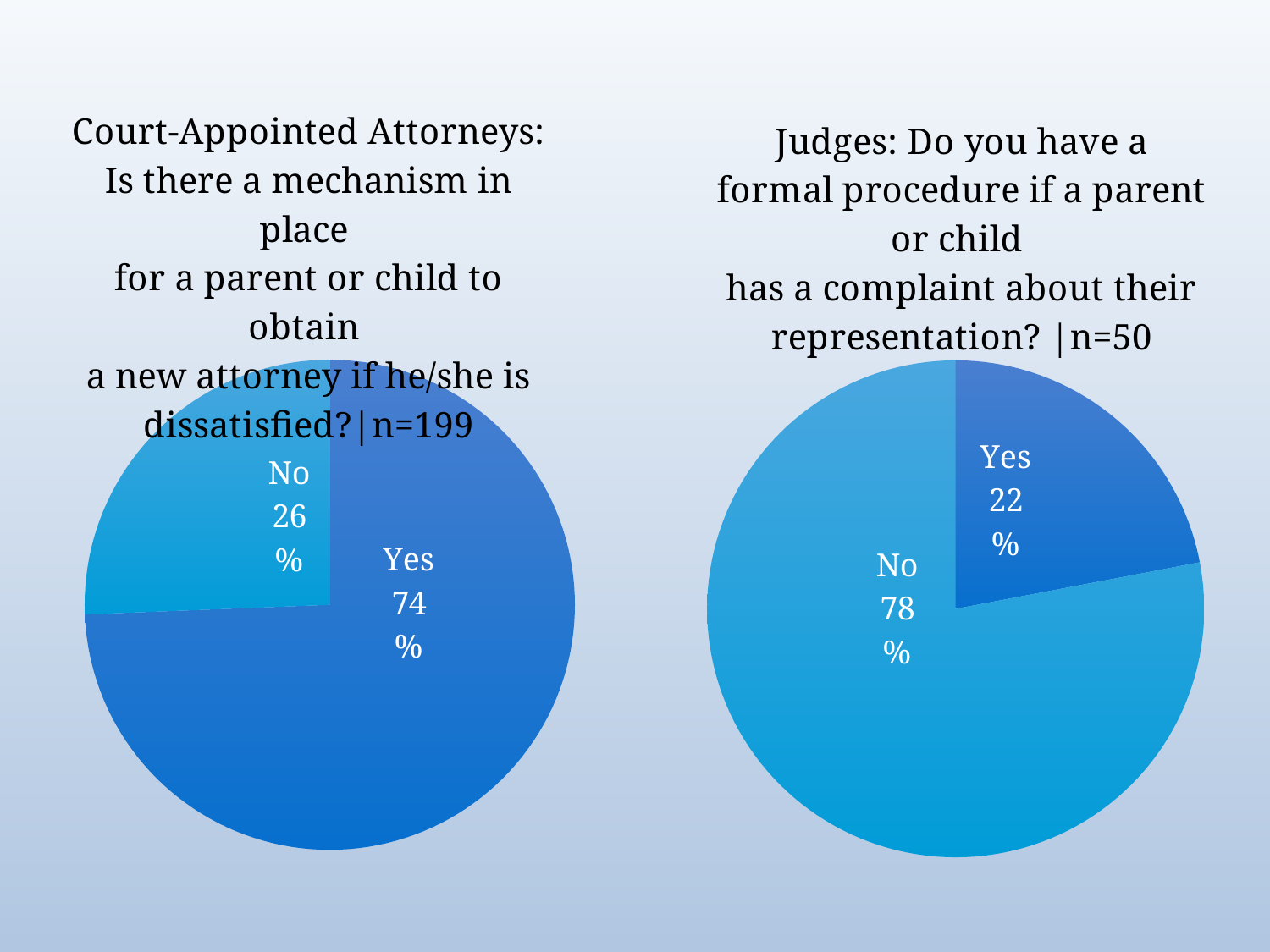
In the left chart (Court-Appointed Attorneys), what is the difference in percentage points between Yes and No? 48 Is the Yes share larger in the left chart (Court-Appointed Attorneys) or the right chart (Judges)? Left chart (Court-Appointed Attorneys) In the right chart (Judges), what percentage answered Yes? 22% In the left chart (Court-Appointed Attorneys), what percentage answered No? 26% What type of chart is the left chart (Court-Appointed Attorneys)? Pie chart In the left chart (Court-Appointed Attorneys), what percentage answered Yes? 74% What is the sample size (n) shown in the title of the right chart (Judges)? n=50 In the right chart (Judges), what percentage answered No? 78% In the left chart (Court-Appointed Attorneys), which response has the larger share? Yes In the right chart (Judges), which response has the smaller share? Yes How many slices does the right chart (Judges) have? 2 In the right chart (Judges), what is the difference in percentage points between No and Yes? 56